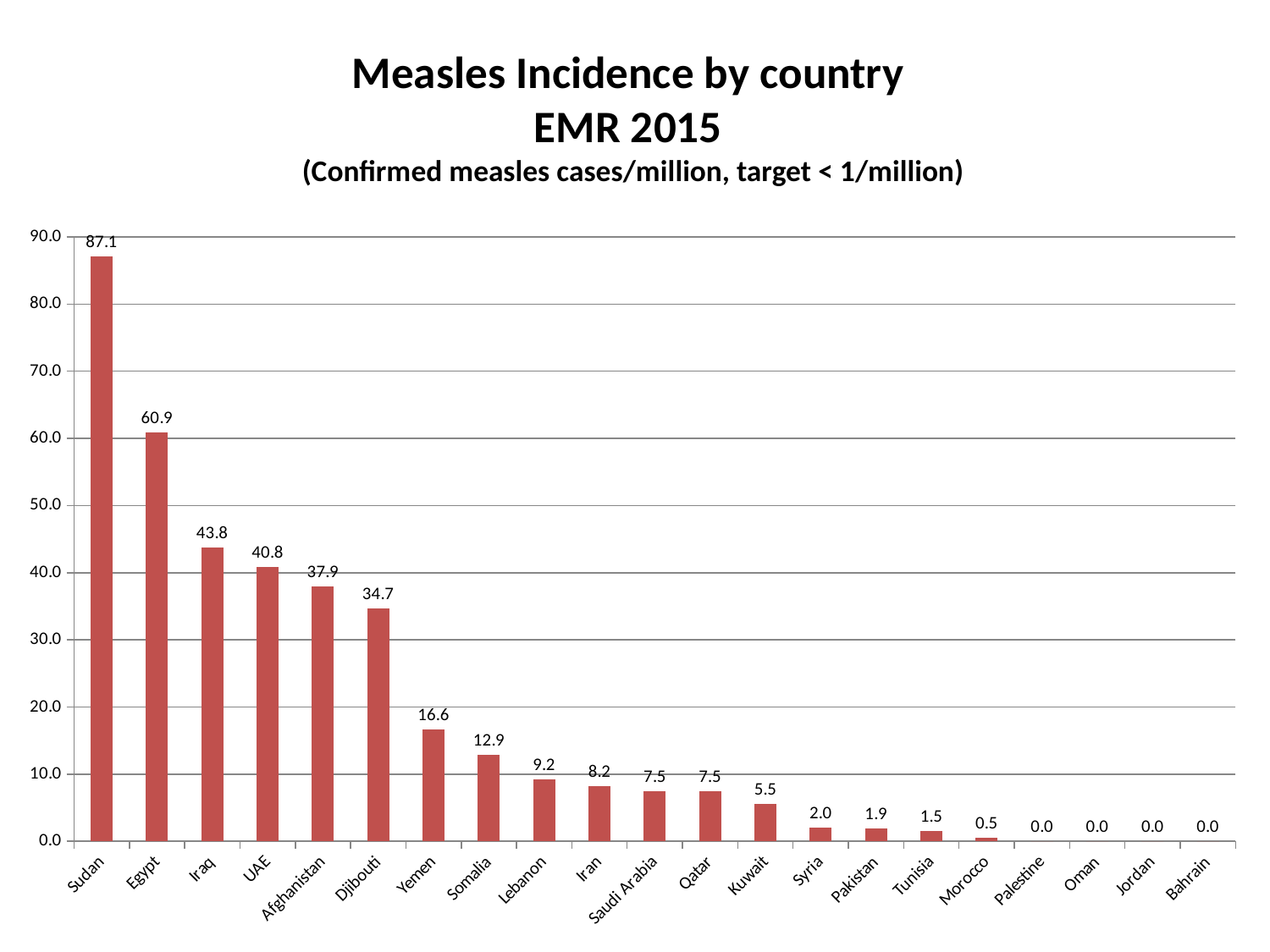
What is the value shown for Kuwait? 5.5 What kind of chart is shown on the slide? Bar chart How many countries are shown on the x axis? 21 What is the difference between the values for Egypt and Iraq? 17.1 What is the difference between the values for Yemen and Somalia? 3.7 Do the values rise or fall moving from left to right along the x axis? Fall Which has a larger value, UAE or Djibouti? UAE What is the measles incidence value shown for Sudan? 87.1 What value is labelled for Afghanistan? 37.9 How many countries show a value of 0.0? 4 Which has a larger value, Lebanon or Iran? Lebanon Which country has the highest measles incidence on the chart? Sudan